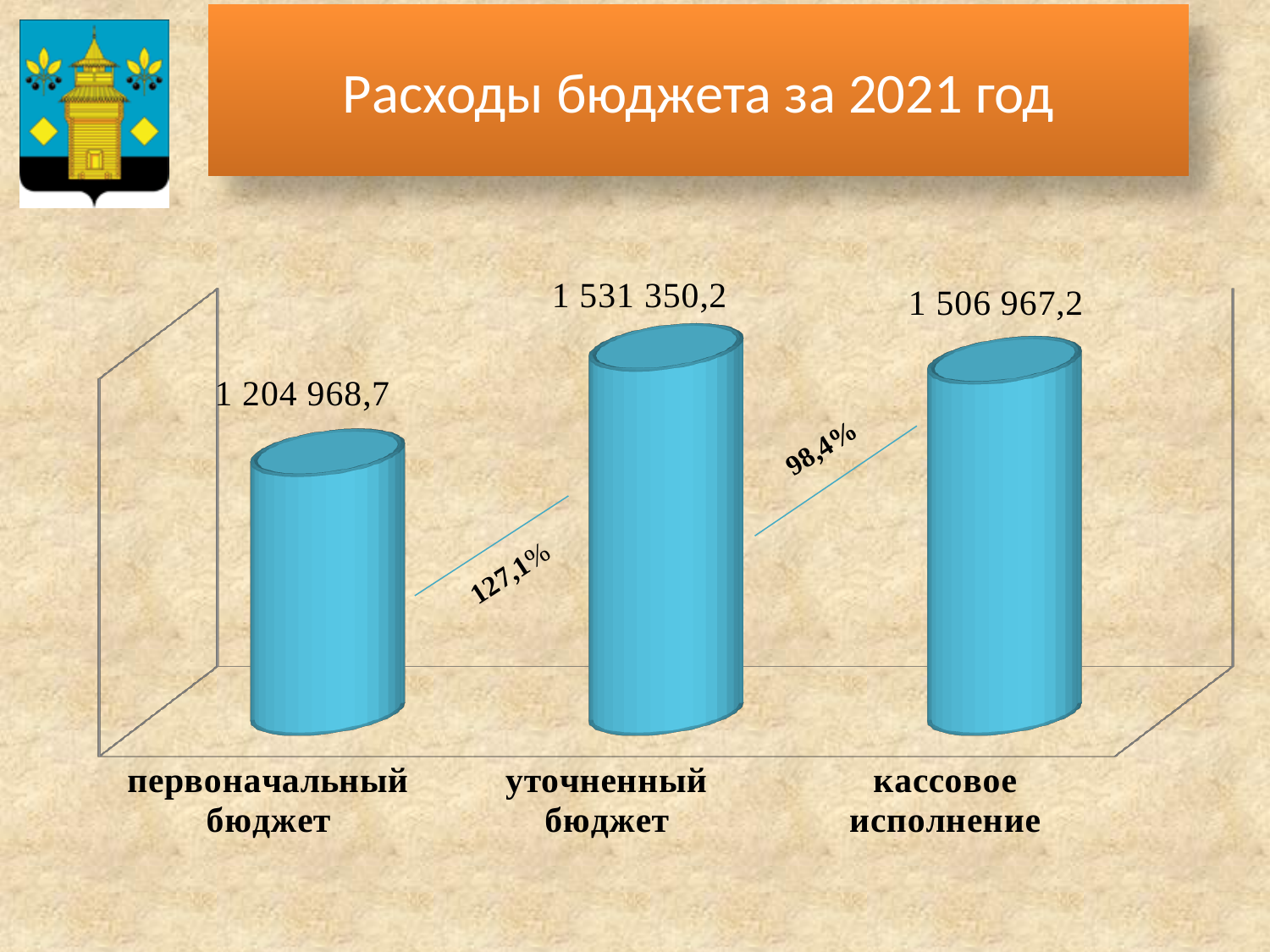
What is the difference between «уточненный бюджет» and «первоначальный бюджет»? 326 381,5 What kind of chart is shown on the slide? bar chart What is the difference between «уточненный бюджет» and «кассовое исполнение»? 24 383,0 What percentage is written between «первоначальный бюджет» and «уточненный бюджет»? 127,1% Which category has the highest value? уточненный бюджет Which category has the lowest value? первоначальный бюджет Which is larger, «уточненный бюджет» or «кассовое исполнение»? уточненный бюджет What is the value for «кассовое исполнение»? 1 506 967,2 What is the title of the slide? Расходы бюджета за 2021 год What is the value for «первоначальный бюджет»? 1 204 968,7 What is the value for «уточненный бюджет»? 1 531 350,2 How many categories are shown in the chart? 3